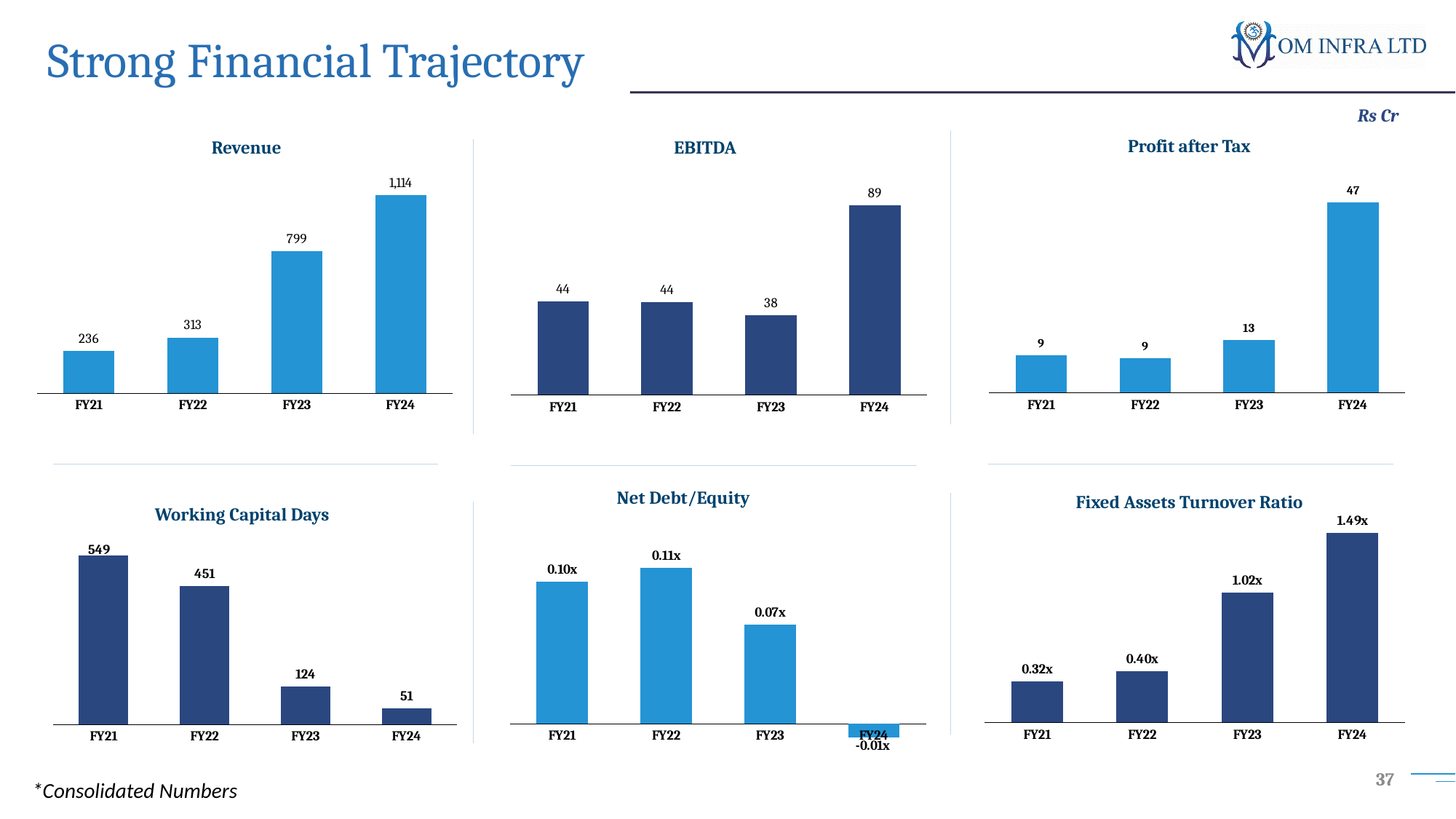
In the EBITDA chart, which year has the highest value? FY24 In the Revenue chart, how many years are shown? 4 In the Profit after Tax chart, what is the difference between FY24 and FY23? 34 In the Working Capital Days chart, what is the value for FY22? 451 In the Working Capital Days chart, do the values rise or fall from FY21 to FY24? fall In the Net Debt/Equity chart, what is the value for FY24? -0.01x In the Revenue chart, what is the value for FY24? 1,114 How many charts are on the slide? 6 In the Fixed Assets Turnover Ratio chart, which is larger, FY22 or FY23? FY23 What kind of chart is the Profit after Tax chart? bar chart In the EBITDA chart, which year has the lowest value? FY23 In the Revenue chart, what is the difference between FY23 and FY22? 486